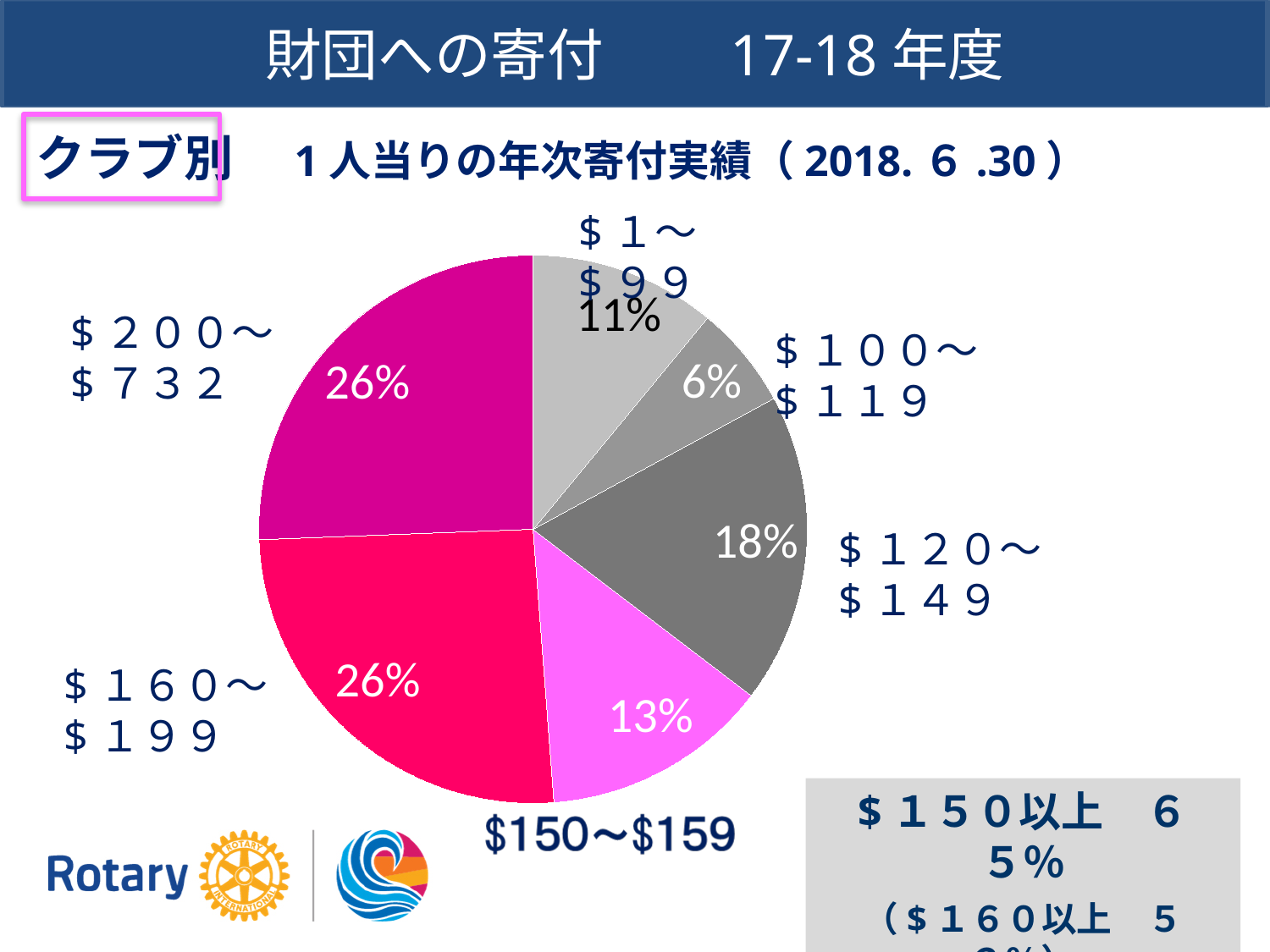
What is the date shown in the chart's subtitle? 2018.6.30 What is the difference in percentage points between the $２００〜$７３２ slice and the $１〜$９９ slice? 15 What percentage of the pie is the $１〜$９９ slice? 11% How many slices does the pie chart have? 6 What percentage of the pie is the $１００〜$１１９ slice? 6% What percentage of the pie is the $150〜$159 slice? 13% What percentage of the pie is the $１２０〜$１４９ slice? 18% What kind of chart is shown on the slide? pie chart What is the combined share of the $１６０〜$１９９ and $２００〜$７３２ slices? 52% Which slice of the pie chart is the smallest? $１００〜$１１９ What percentage of the pie is the $１６０〜$１９９ slice? 26% Which is larger, the $１２０〜$１４９ slice or the $150〜$159 slice? $１２０〜$１４９